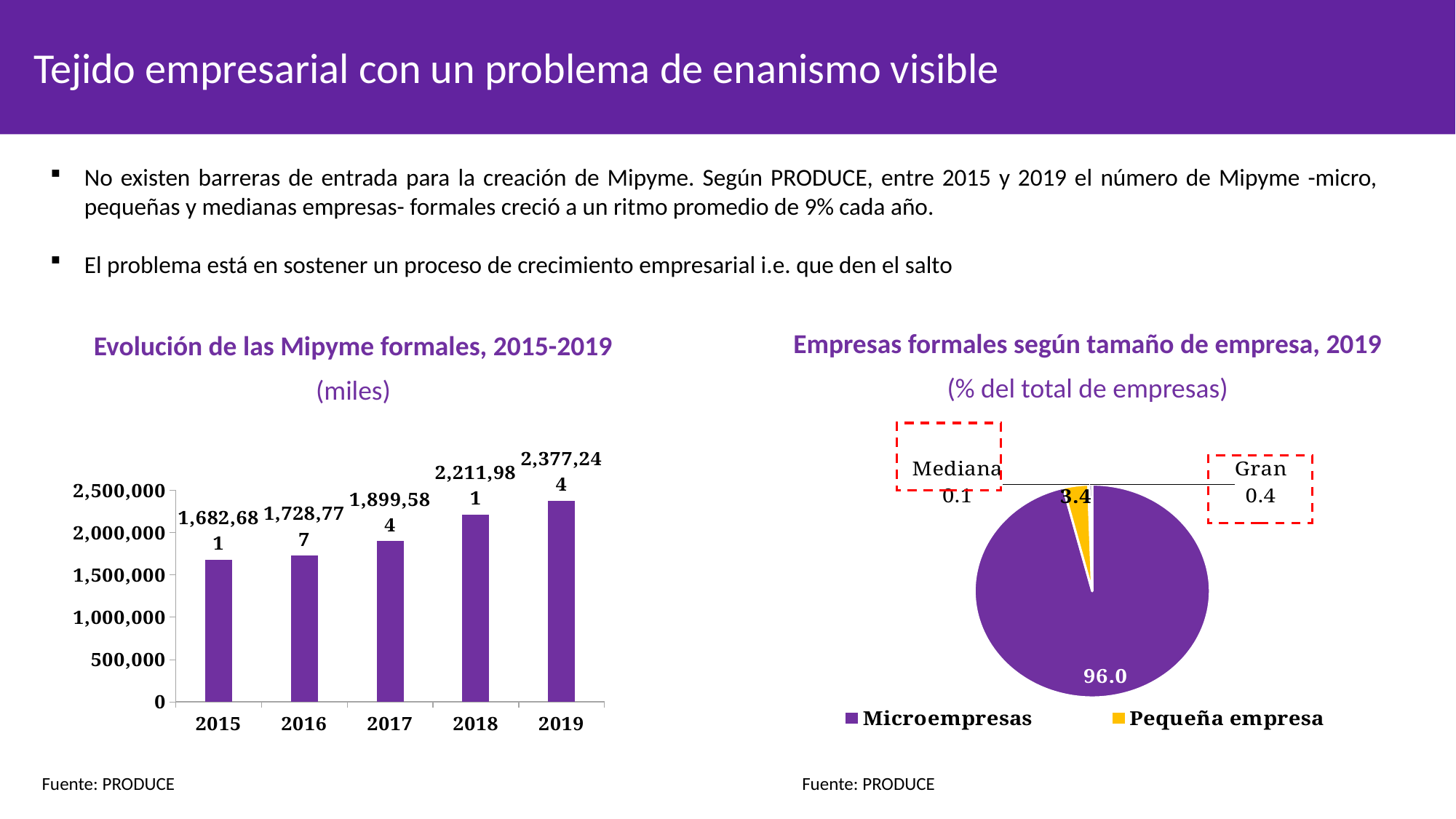
How many entries does the legend of the chart 'Empresas formales según tamaño de empresa, 2019' list? 2 In the chart 'Empresas formales según tamaño de empresa, 2019', which is larger, Mediana or Gran? Gran In the chart 'Evolución de las Mipyme formales, 2015-2019', do the values rise or fall from 2015 to 2019? rise In the chart 'Evolución de las Mipyme formales, 2015-2019', what is the value for 2015? 1,682,681 In the chart 'Evolución de las Mipyme formales, 2015-2019', which year has the lowest value? 2015 What kind of chart is 'Evolución de las Mipyme formales, 2015-2019'? bar chart In the chart 'Evolución de las Mipyme formales, 2015-2019', what is the value for 2019? 2,377,244 In the chart 'Evolución de las Mipyme formales, 2015-2019', what is the difference between the 2019 and 2015 values? 694,563 In the chart 'Empresas formales según tamaño de empresa, 2019', what is the share for Microempresas? 96.0 In the chart 'Evolución de las Mipyme formales, 2015-2019', how many years are shown on the x axis? 5 In the chart 'Evolución de las Mipyme formales, 2015-2019', which year has the highest value? 2019 In the chart 'Empresas formales según tamaño de empresa, 2019', what is the value for Pequeña empresa? 3.4